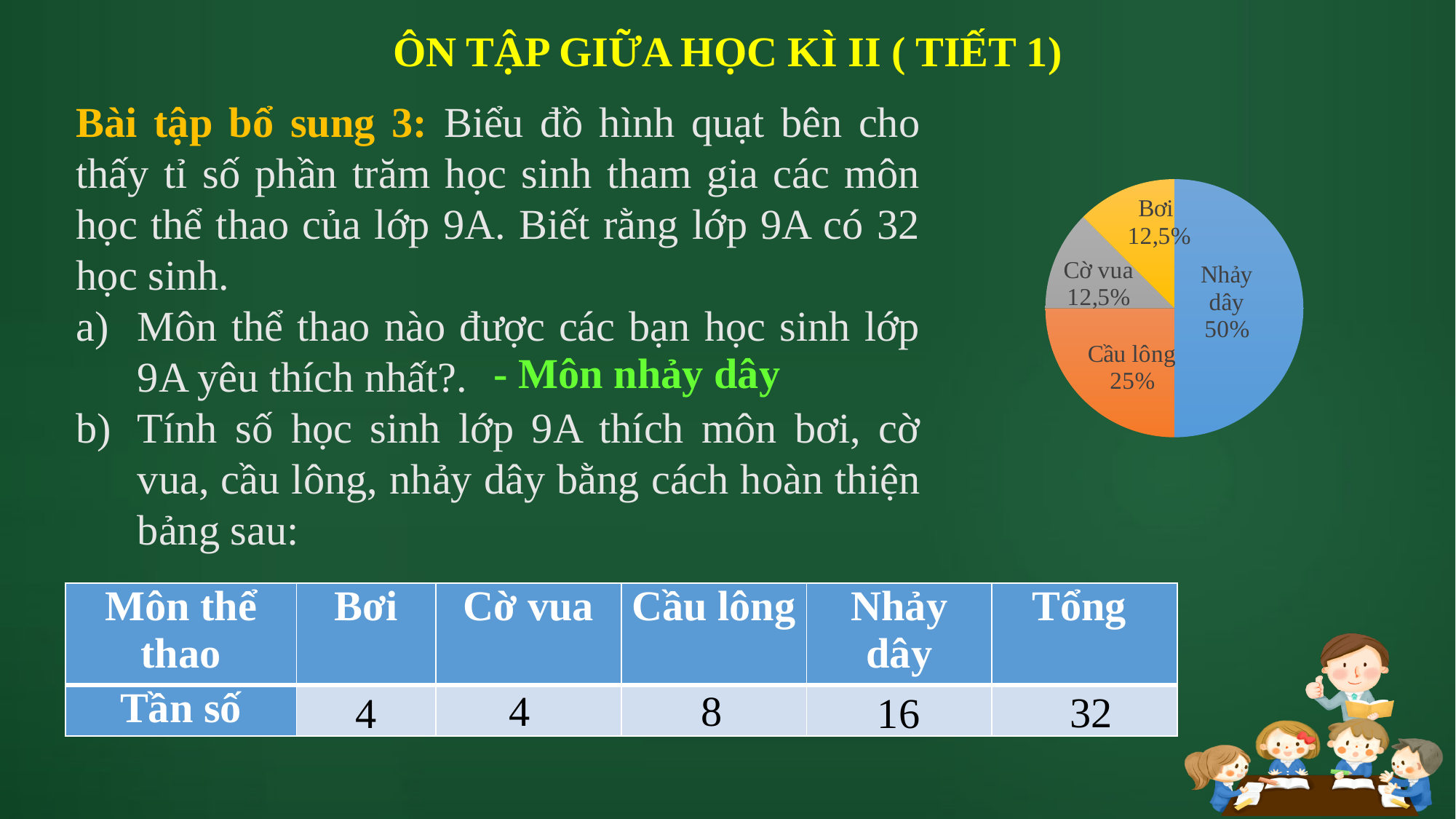
What kind of chart is shown on the slide? pie chart What share of the pie chart does Cầu lông take up? 25% What percentage does the pie chart show for Cờ vua? 12,5% What percentage does the pie chart show for Cầu lông? 25% What percentage does the pie chart show for Bơi? 12,5% Which sport has the largest slice in the pie chart? Nhảy dây What is the combined share of Bơi and Cờ vua in the pie chart? 25% What colour is the Nhảy dây slice in the pie chart? blue How many slices does the pie chart have? 4 What is the difference in percentage points between Nhảy dây and Cầu lông in the pie chart? 25% Which slice is larger in the pie chart, Cầu lông or Bơi? Cầu lông What percentage does the pie chart show for Nhảy dây? 50%